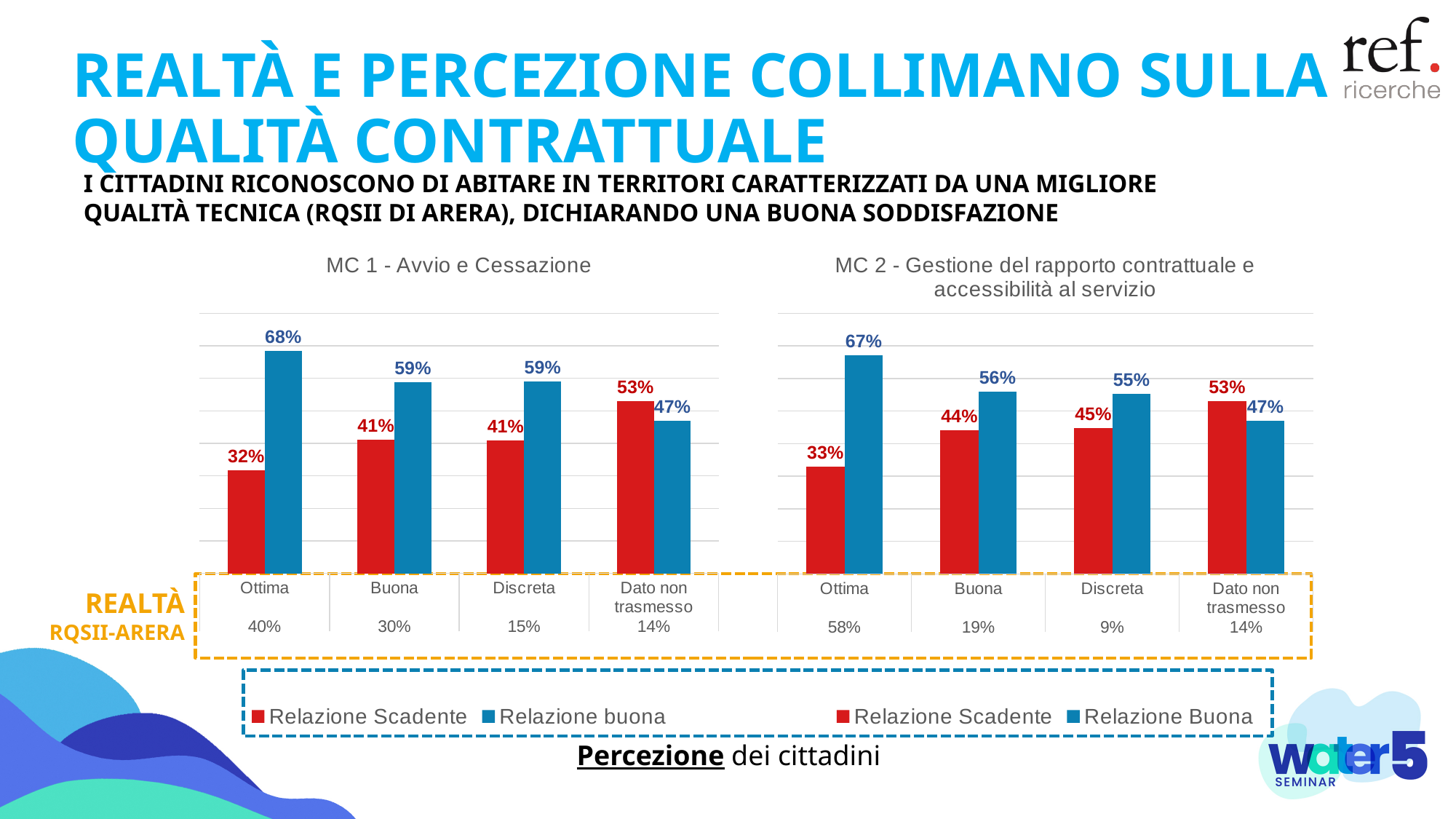
What kind of chart is 'MC 1 - Avvio e Cessazione'? Bar chart In the chart 'MC 1 - Avvio e Cessazione', what is the value of Relazione buona for Ottima? 68% In the chart 'MC 2 - Gestione del rapporto contrattuale e accessibilità al servizio', do the Relazione Buona values rise or fall from Ottima to Dato non trasmesso? Fall How many categories are shown on the x axis of the chart 'MC 1 - Avvio e Cessazione'? 4 In the chart 'MC 2 - Gestione del rapporto contrattuale e accessibilità al servizio', what is the value of Relazione Buona for Discreta? 55% How many series does the legend list for the chart 'MC 2 - Gestione del rapporto contrattuale e accessibilità al servizio'? 2 In the chart 'MC 1 - Avvio e Cessazione', what is the value of Relazione Scadente for Dato non trasmesso? 53% In the chart 'MC 2 - Gestione del rapporto contrattuale e accessibilità al servizio', what is the value of Relazione Scadente for Buona? 44% In the chart 'MC 1 - Avvio e Cessazione', which category has the highest Relazione buona value? Ottima In the chart 'MC 2 - Gestione del rapporto contrattuale e accessibilità al servizio', which category has the lowest Relazione Scadente value? Ottima In the chart 'MC 2 - Gestione del rapporto contrattuale e accessibilità al servizio', which is larger for Dato non trasmesso: Relazione Scadente or Relazione Buona? Relazione Scadente In the chart 'MC 1 - Avvio e Cessazione', what is the difference between Relazione buona and Relazione Scadente for Ottima? 36%